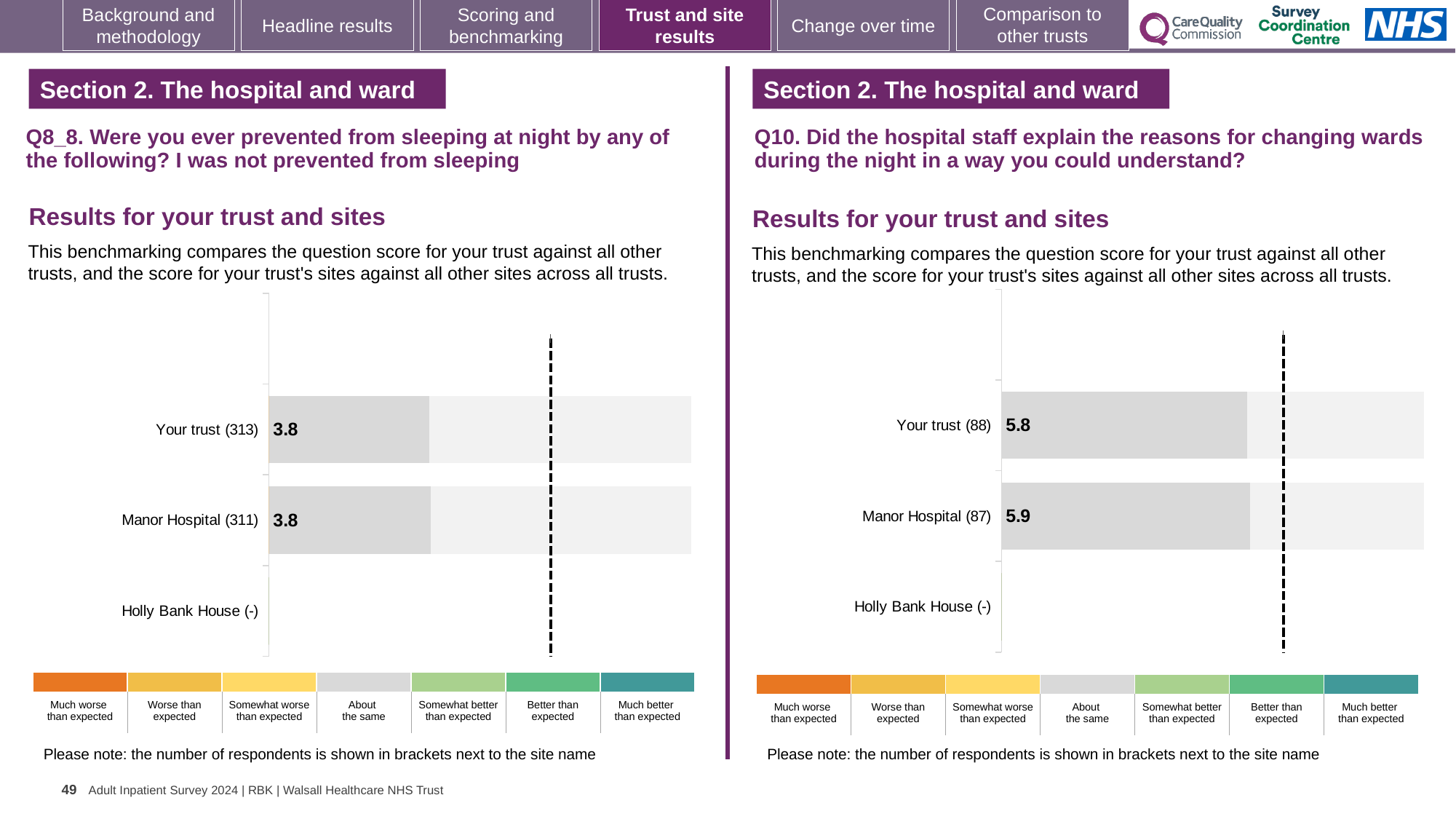
In the Q10 chart on the right, what is the score for Manor Hospital (87)? 5.9 In the Q8_8 chart on the left, what is the score for Your trust (313)? 3.8 In the Q8_8 chart on the left, what is the difference between the Your trust score and the Manor Hospital score? 0 What kind of chart is used for the Q10 results on the right? Bar chart In the Q10 chart on the right, what is the score for Your trust (88)? 5.8 In the Q10 chart on the right, what is the difference between the Manor Hospital score and the Your trust score? 0.1 In the Q8_8 chart on the left, what is the score for Manor Hospital (311)? 3.8 How many benchmark categories are shown in the colour legend below the Q8_8 chart on the left? 7 In the Q10 chart on the right, which has the higher score, Your trust or Manor Hospital? Manor Hospital In the Q8_8 chart on the left, how many respondents are shown in brackets for Manor Hospital? 311 How many site/trust categories are listed on the y axis of the Q8_8 chart on the left? 3 In the Q10 chart on the right, which site has no score shown? Holly Bank House